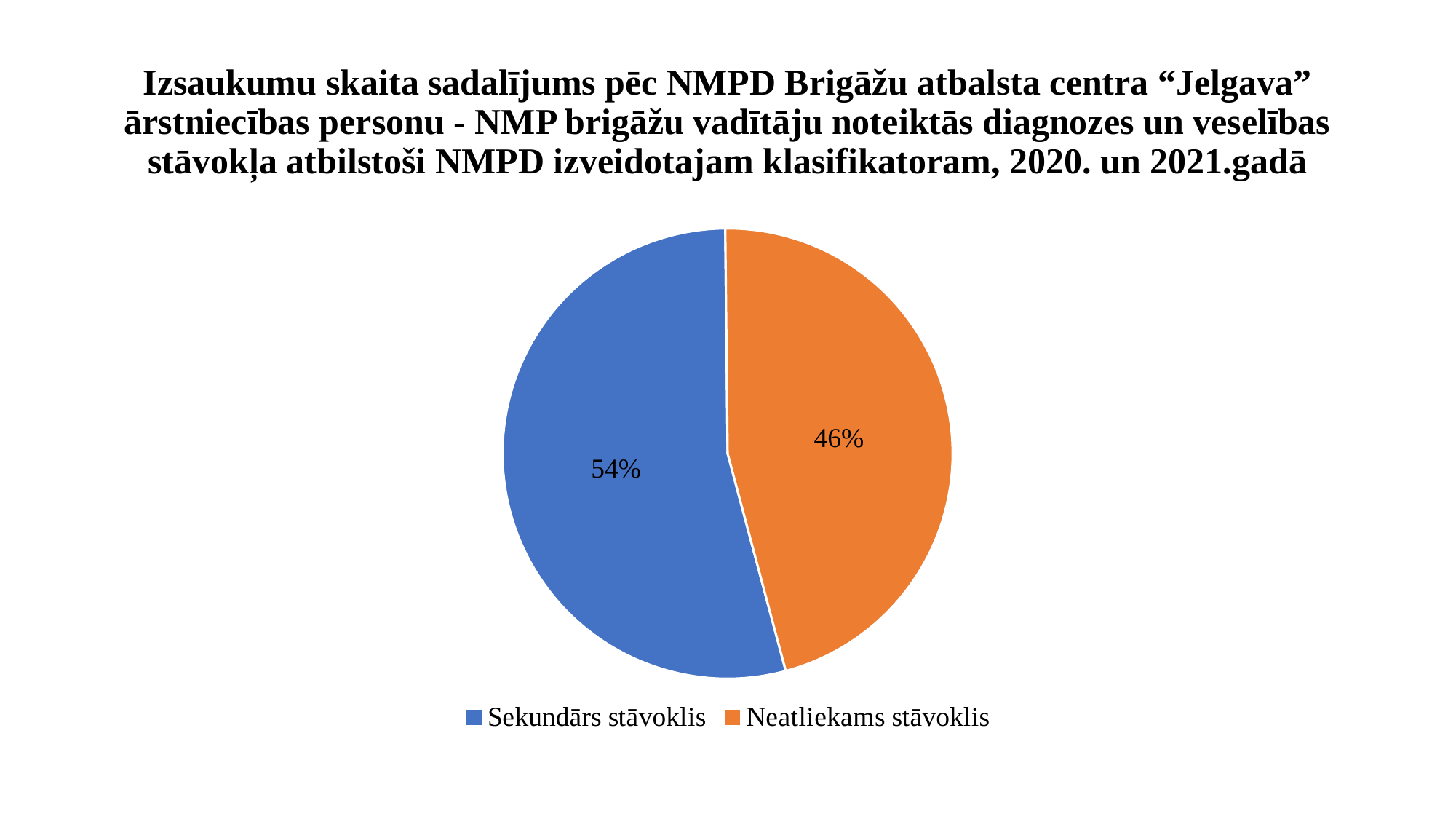
Which is larger: the share for Sekundārs stāvoklis or the share for Neatliekams stāvoklis? Sekundārs stāvoklis What colour is the slice for Neatliekams stāvoklis? orange Which category has the smallest slice of the pie? Neatliekams stāvoklis What share of the pie does Sekundārs stāvoklis represent? 54% What is the difference in percentage points between Sekundārs stāvoklis and Neatliekams stāvoklis? 8 percentage points What type of chart is shown on the slide? pie chart Which category has the largest slice of the pie? Sekundārs stāvoklis How many slices does the pie chart have? 2 What share of the pie does Neatliekams stāvoklis represent? 46% Is the share for Neatliekams stāvoklis greater or less than 50%? less Which years does the chart title say the data covers? 2020 and 2021 How many entries does the legend list? 2